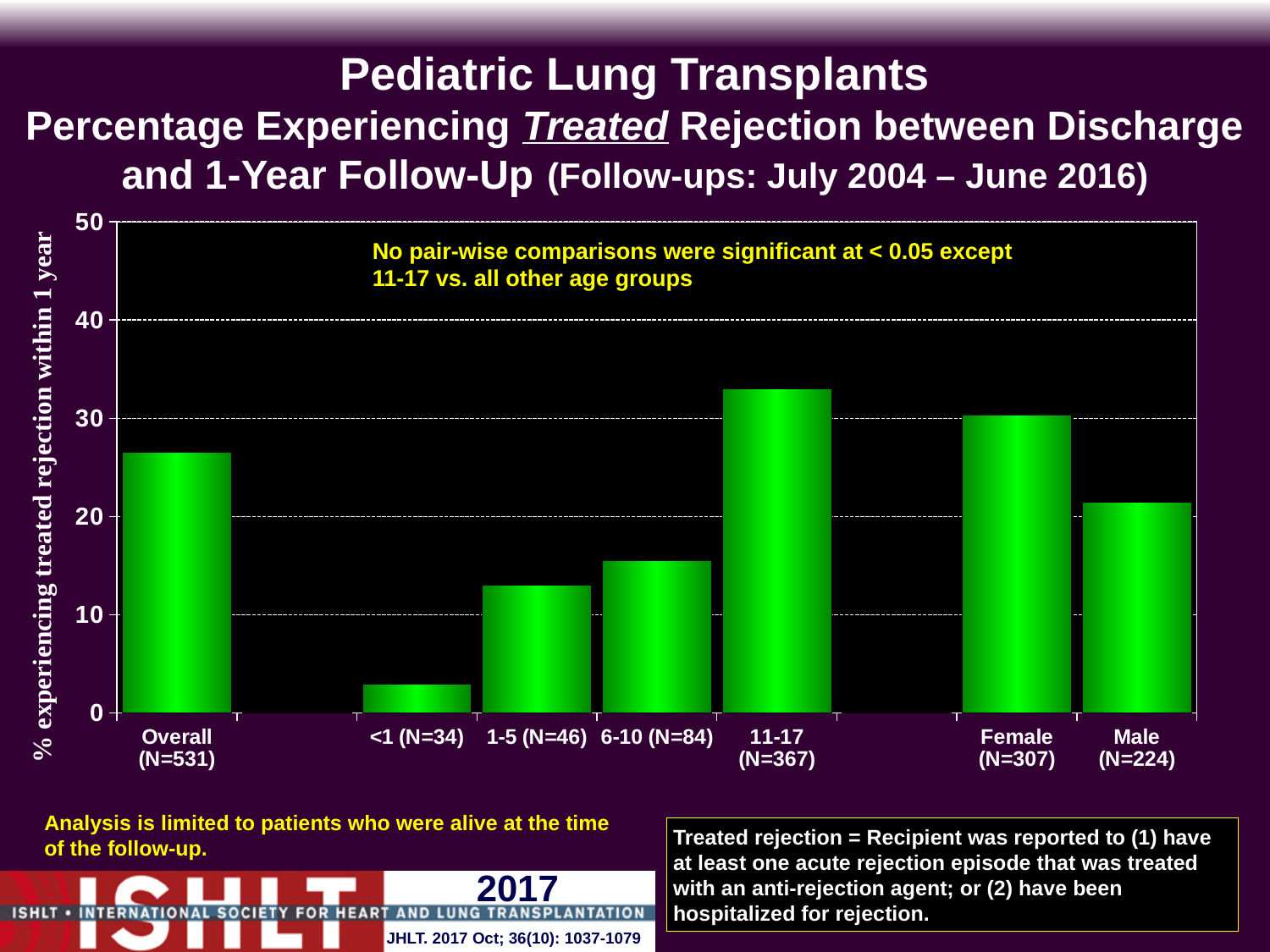
What is the label of the y-axis? % experiencing treated rejection within 1 year Is the value for 11-17 (N=367) greater or less than 30? greater How many bars (categories) are plotted in the chart? 7 What kind of chart is shown on the slide? bar chart Which category has the lowest percentage experiencing treated rejection within 1 year? <1 (N=34) Which category has the highest percentage experiencing treated rejection within 1 year? 11-17 (N=367) According to the note inside the chart, which age group's pair-wise comparisons were significant at < 0.05? 11-17 vs. all other age groups Is the value for <1 (N=34) greater or less than 10? less Which has a higher percentage experiencing treated rejection, Female (N=307) or Male (N=224)? Female (N=307) Is the value for Overall (N=531) greater or less than 20? greater Which has a higher percentage experiencing treated rejection, 1-5 (N=46) or 6-10 (N=84)? 6-10 (N=84)